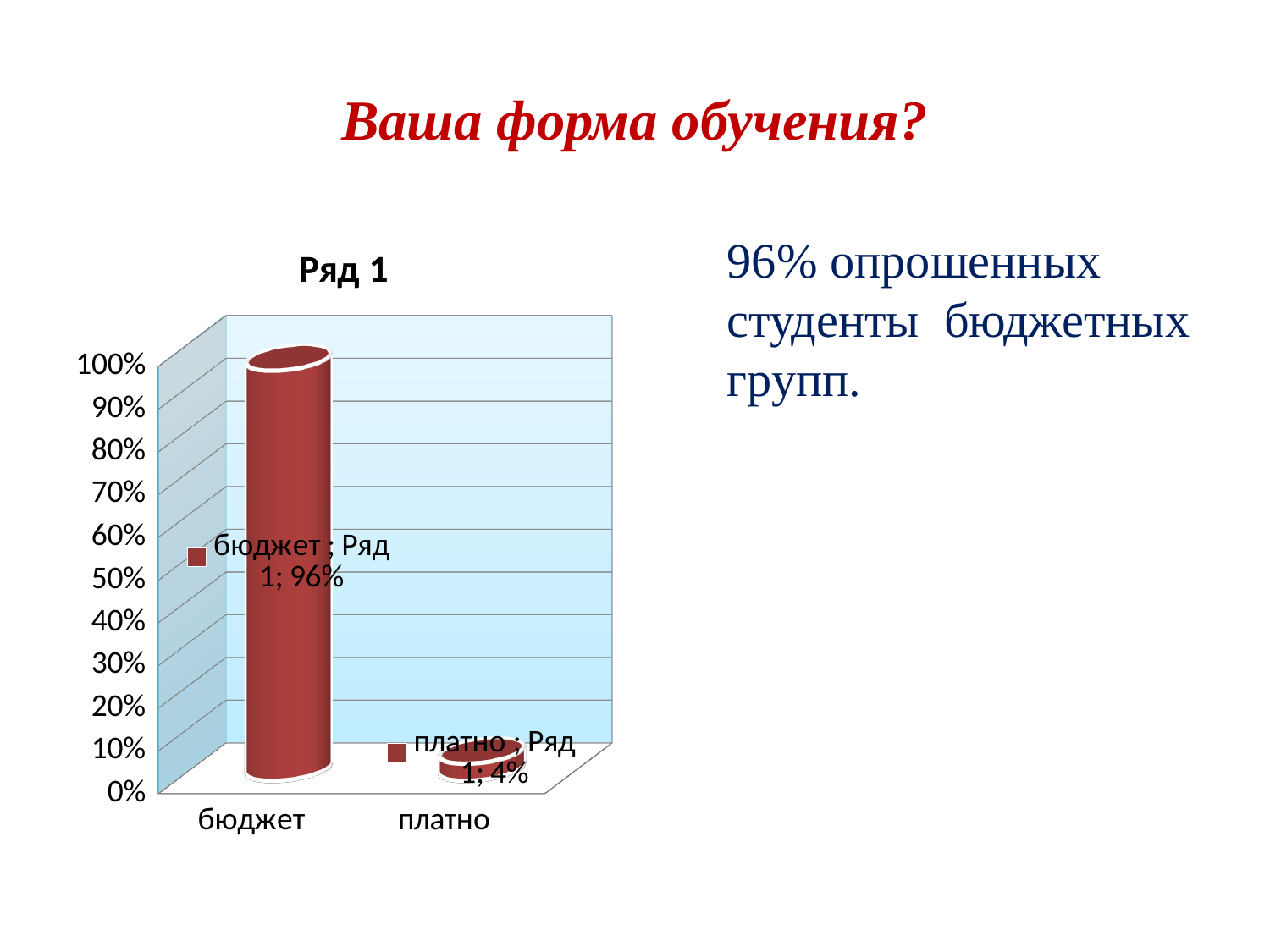
What is the difference between the values for бюджет and платно? 92% What is the title of the chart? Ряд 1 How many categories are shown on the x axis? 2 Which is larger, the value for бюджет or the value for платно? бюджет Is the value for платно greater or less than 10%? less What kind of chart is shown on the slide? bar chart Which category has the highest value? бюджет What is the value for платно? 4% Is the value for бюджет greater or less than 90%? greater What is the value for бюджет? 96% What is the total of the values for бюджет and платно? 100% Which category has the lowest value? платно